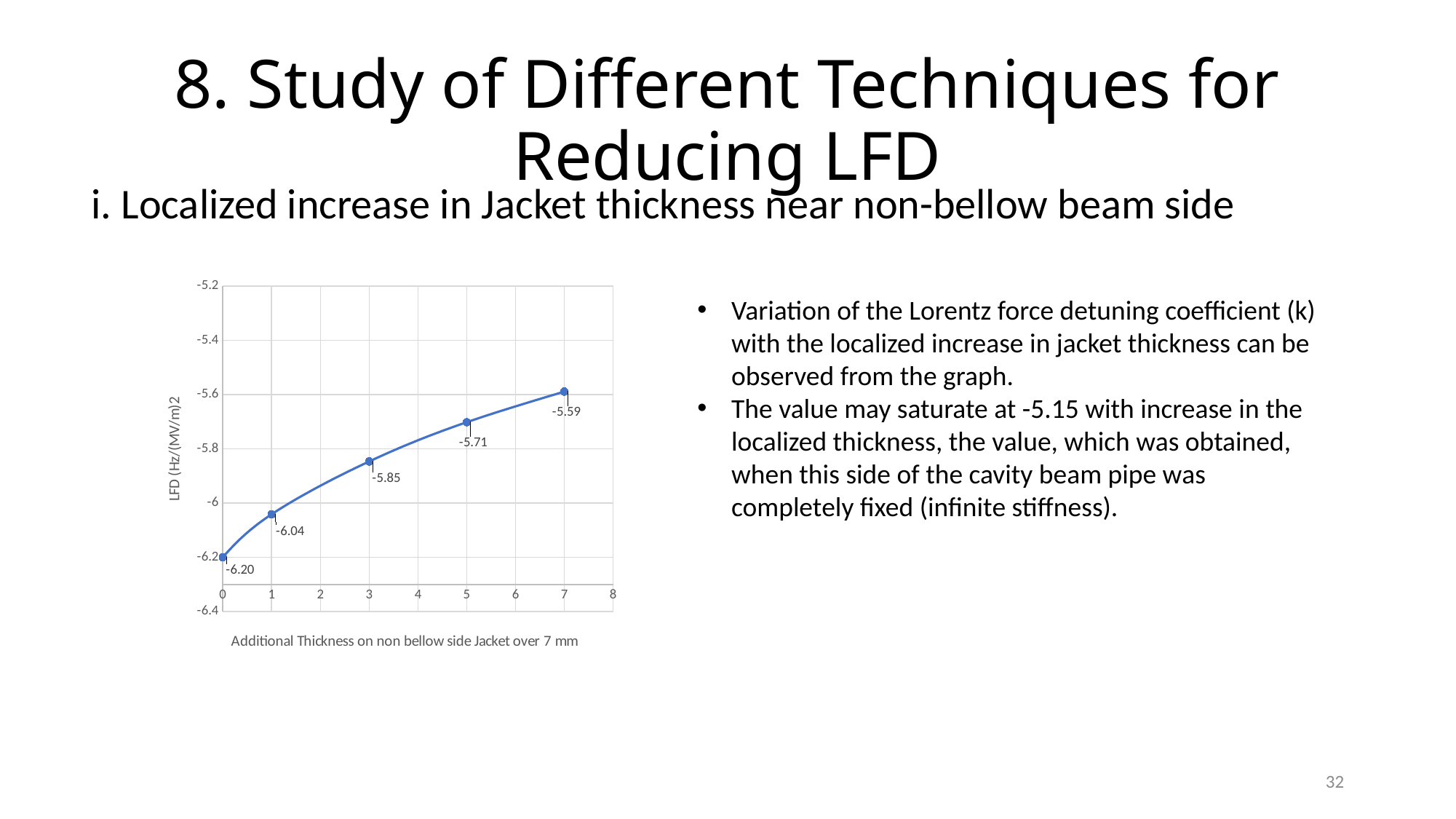
What is the LFD value at an additional thickness of 3 mm? -5.85 What is the LFD value at an additional thickness of 1 mm? -6.04 What is the LFD value at an additional thickness of 7 mm? -5.59 At which additional thickness is the LFD value lowest (most negative)? 0 How many data points are plotted on the chart? 5 At which additional thickness is the LFD value highest (least negative)? 7 What is the label of the x axis of the chart? Additional Thickness on non bellow side Jacket over 7 mm Which is larger, the LFD value at 5 mm or at 1 mm additional thickness? 5 mm What is the difference between the LFD values at 7 mm and 0 mm additional thickness? 0.61 What kind of chart is shown on the slide? Line chart What is the LFD value at an additional thickness of 0 mm? -6.20 Do the LFD values rise or fall as the additional thickness increases? Rise